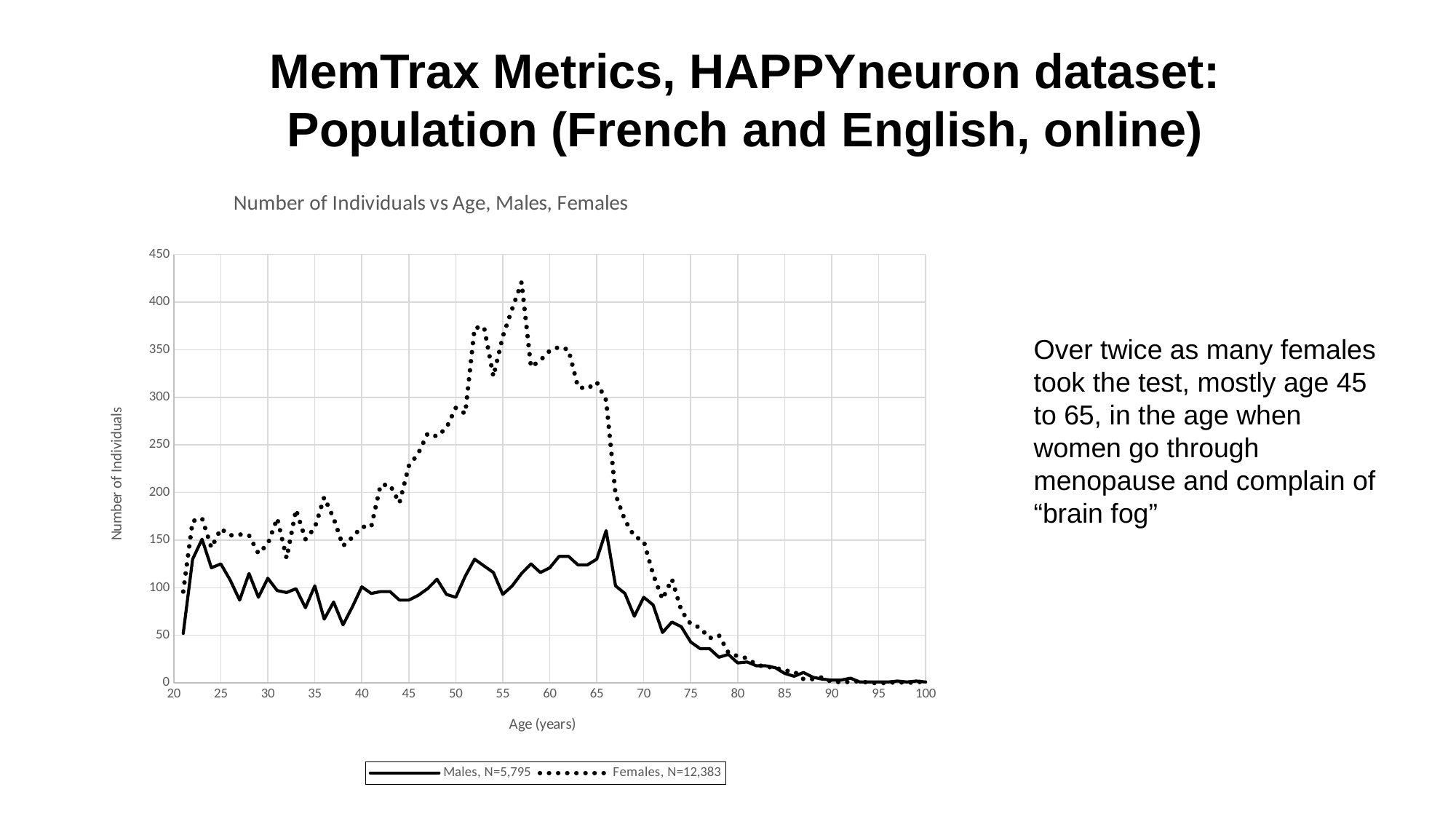
How many series does the legend list? 2 Which series reaches the higher peak value on the chart? Females, N=12,383 What is the title of the chart? Number of Individuals vs Age, Males, Females Is the value for Males at age 38 greater or less than 100? less Is the value for Females at age 50 greater or less than 250? greater What kind of chart is shown on the slide? line chart At age 57, which series has the larger value, Males or Females? Females Do the values for Females rise or fall between age 65 and age 80? fall Is the value for Females at age 57 greater or less than 400? greater What are the two legend entries of the chart? Males, N=5,795 and Females, N=12,383